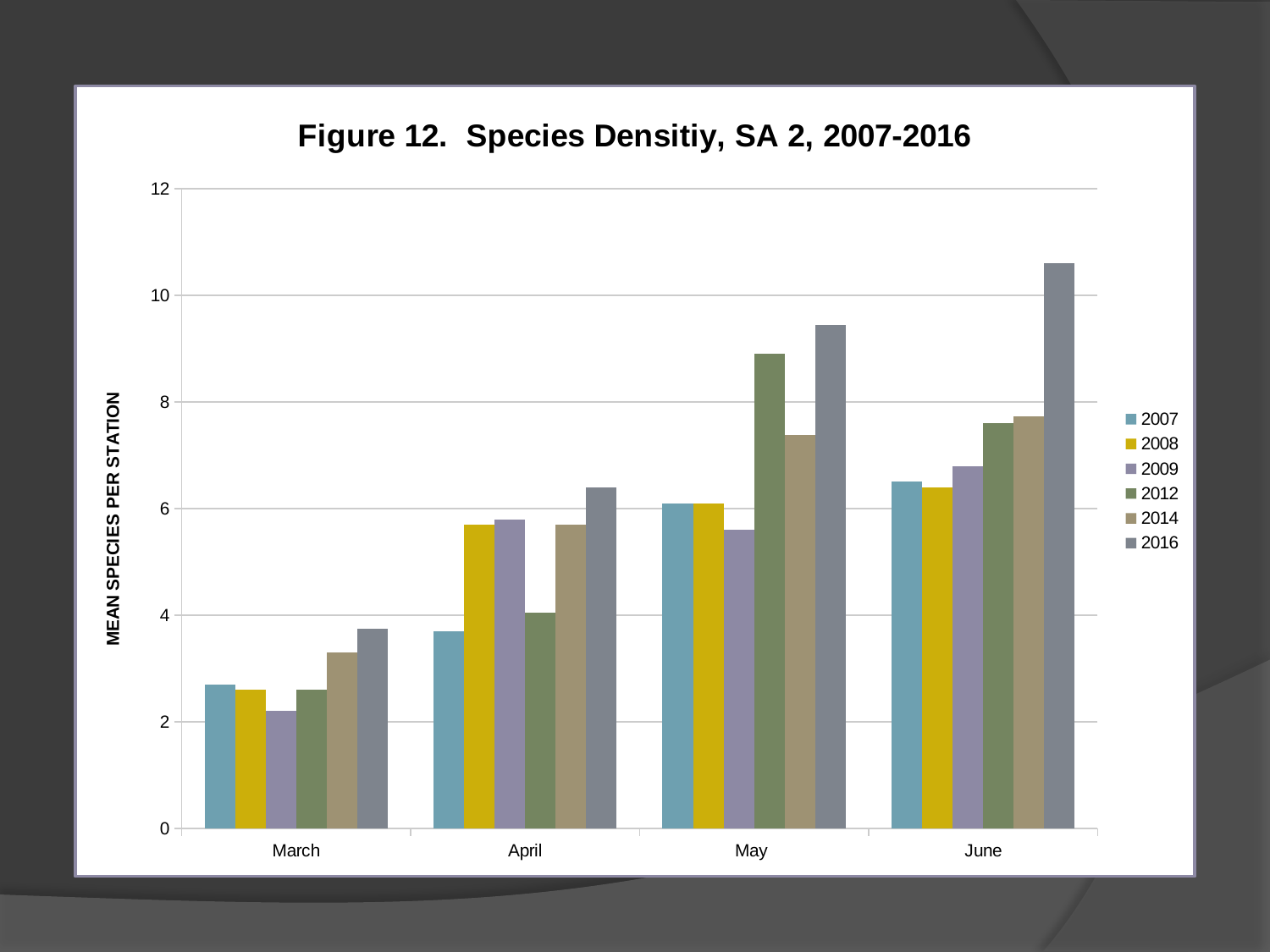
In which month is the 2016 value highest? June Is the value for 2016 in June greater or less than 10? greater What is the label on the y axis? MEAN SPECIES PER STATION How many months are shown on the x axis? 4 In April, which is larger: the value for 2007 or the value for 2012? 2012 How many series does the legend list? 6 What kind of chart is shown on the slide? bar chart Which year has the lowest value in March? 2009 Is the value for 2007 in April greater or less than 4? less Do the 2016 values rise or fall from March to June? rise Is the value for 2012 in May greater or less than 8? greater Which year has the highest value in May? 2016